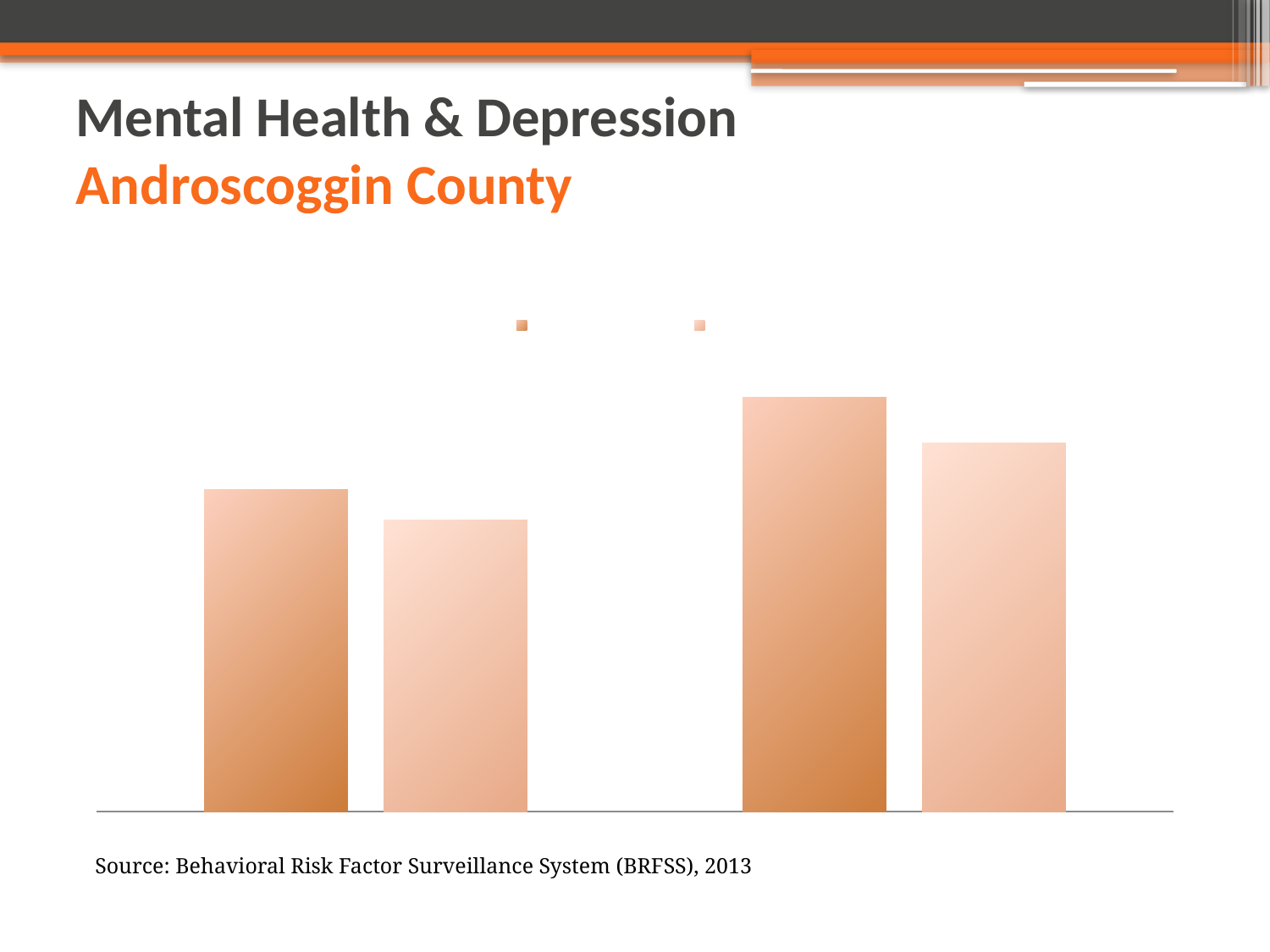
In the right group of bars, is the darker bar or the lighter bar taller? the darker bar Which bar is the shortest in the chart? the lighter bar in the left group (second from left) Is the darker bar in the right group taller or shorter than the darker bar in the left group? taller What kind of chart is shown on the slide? bar chart How many bars are plotted in the chart? 4 Which bar is the tallest in the chart? the darker bar in the right group (third from left) How many series does the chart's legend list? 2 What is the source cited below the chart? Behavioral Risk Factor Surveillance System (BRFSS), 2013 How many groups of bars are there in the chart? 2 Which county does the slide title say the chart is about? Androscoggin County In the left group of bars, is the darker bar or the lighter bar taller? the darker bar